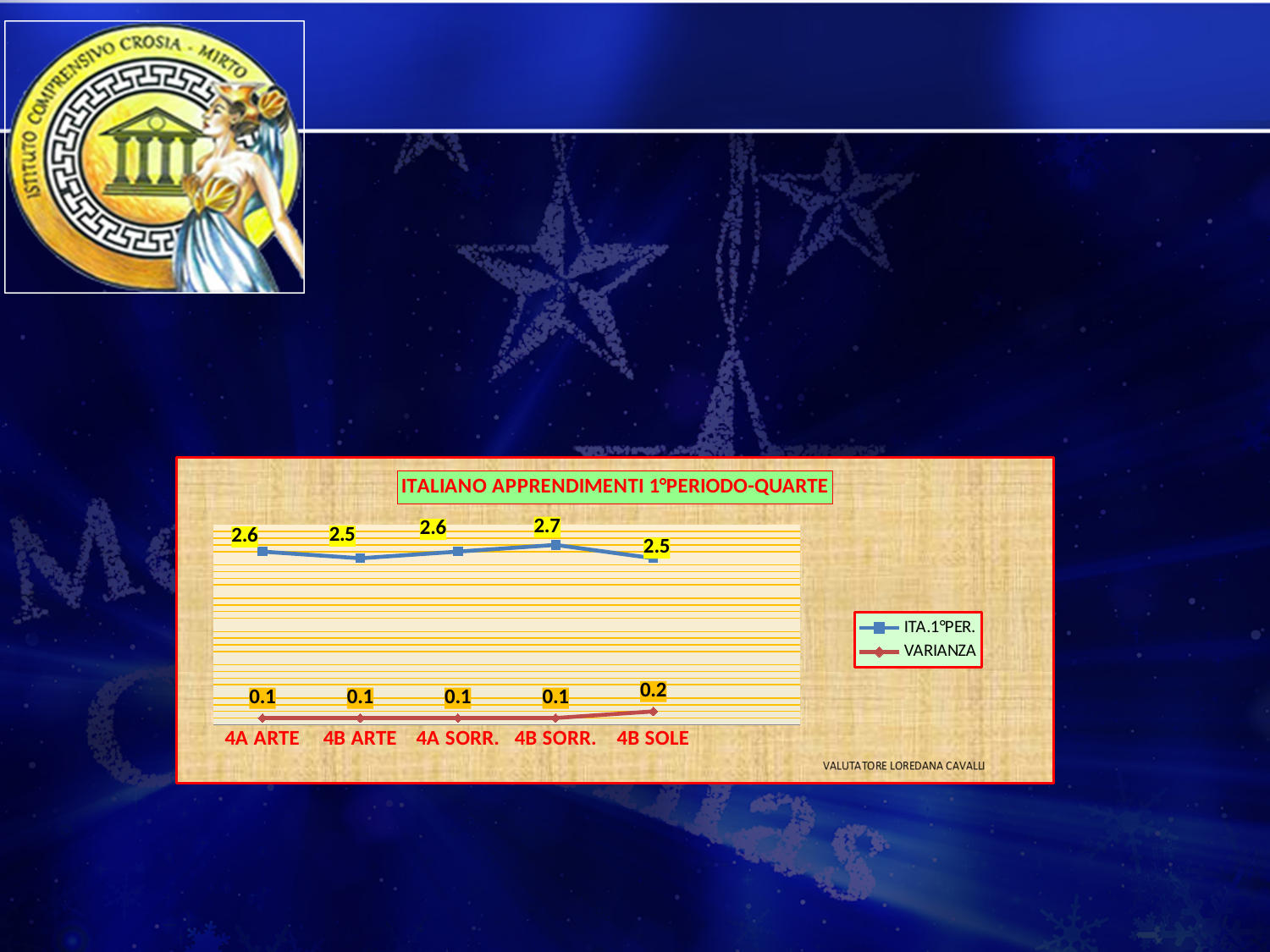
What is the title of the chart? ITALIANO APPRENDIMENTI 1°PERIODO-QUARTE What type of chart is shown on the slide? line chart Which is larger, the ITA.1°PER. value for 4A SORR. or for 4B ARTE? 4A SORR. How many series does the legend list? 2 What is the ITA.1°PER. value for 4B SORR.? 2.7 How many categories are shown on the x axis? 5 Which category has the highest ITA.1°PER. value? 4B SORR. What is the VARIANZA value for 4B SOLE? 0.2 Which category has the highest VARIANZA value? 4B SOLE What is the difference between the ITA.1°PER. values for 4B SORR. and 4B SOLE? 0.2 What is the ITA.1°PER. value for 4A ARTE? 2.6 What is the VARIANZA value for 4A SORR.? 0.1